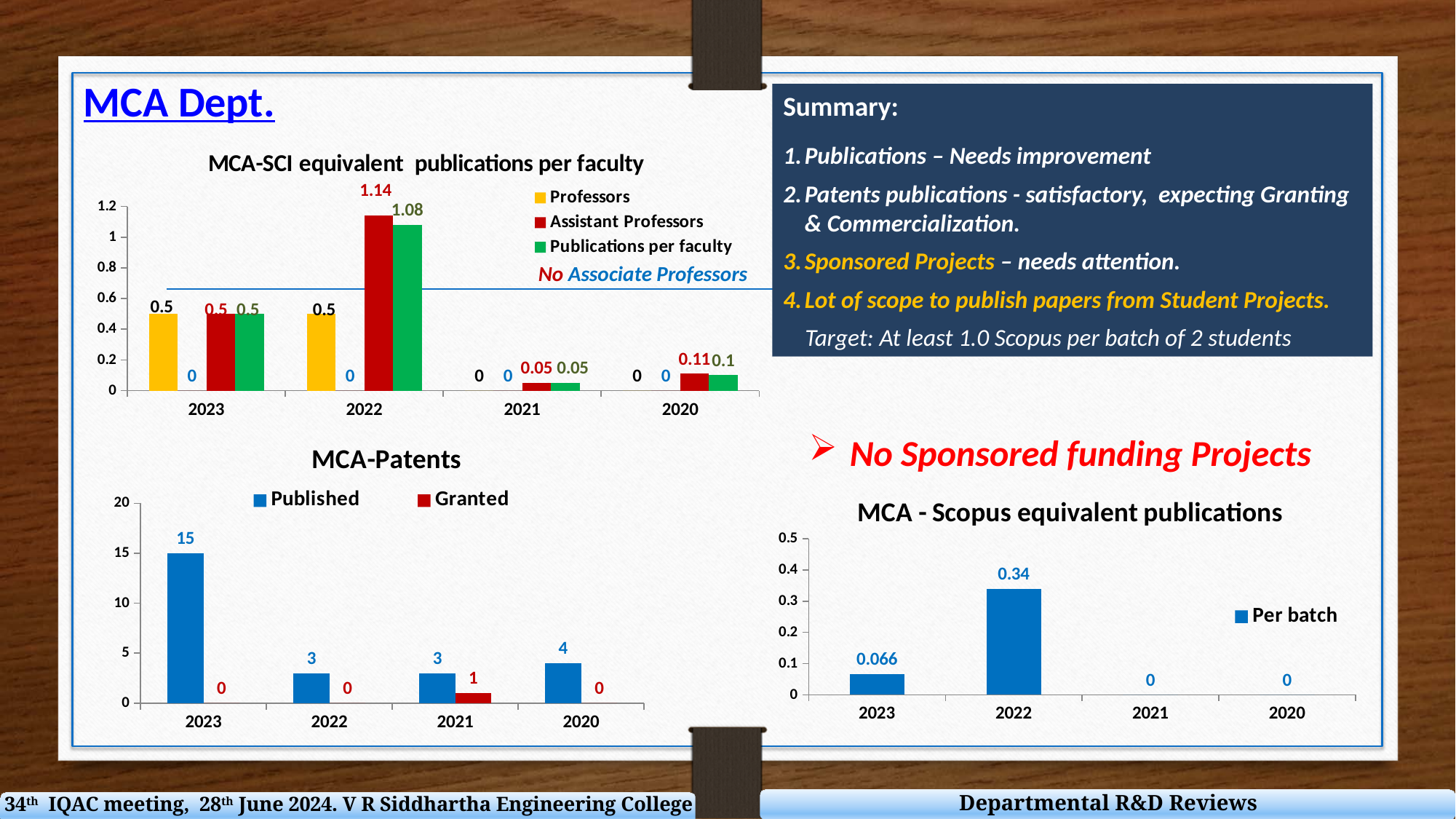
In the 'MCA-SCI equivalent publications per faculty' chart, what is the value for Professors in 2023? 0.5 In the 'MCA-Patents' chart, which year has the only non-zero Granted value? 2021 In the 'MCA - Scopus equivalent publications' chart, which year has the lowest non-zero Per batch value? 2023 In the 'MCA-SCI equivalent publications per faculty' chart, what is the value for Assistant Professors in 2022? 1.14 In the 'MCA-Patents' chart, how many patents were Published in 2023? 15 In the 'MCA-Patents' chart, what is the difference between Published patents in 2023 and 2020? 11 In the 'MCA-SCI equivalent publications per faculty' chart, which year has the highest Publications per faculty value? 2022 How many years are shown on the x axis of the 'MCA - Scopus equivalent publications' chart? 4 In the 'MCA-SCI equivalent publications per faculty' chart, what is the difference between the Publications per faculty values for 2022 and 2020? 0.98 What type of chart is the 'MCA-Patents' chart? Bar chart How many series does the legend of the 'MCA-SCI equivalent publications per faculty' chart list? 3 In the 'MCA - Scopus equivalent publications' chart, what is the Per batch value for 2022? 0.34